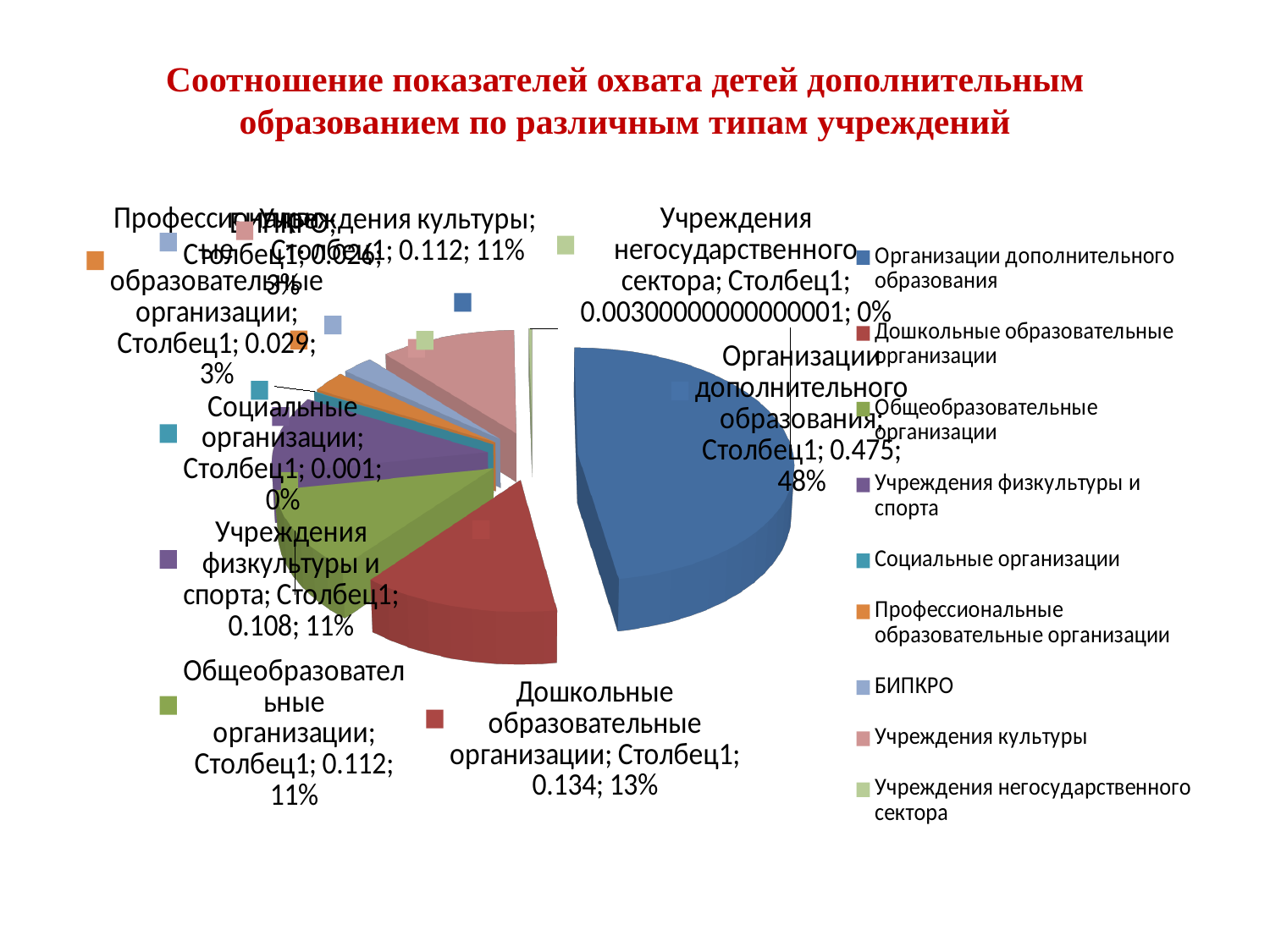
What value is shown for Учреждения физкультуры и спорта? 0.108 What value is shown for Организации дополнительного образования? 0.475 Which category has the largest slice of the pie? Организации дополнительного образования What kind of chart is shown on the slide? pie chart What value is shown for Социальные организации? 0.001 What value is shown for Дошкольные образовательные организации? 0.134 What is the difference between the value for Организации дополнительного образования and the value for Дошкольные образовательные организации? 0.341 What percentage share does the slice for Организации дополнительного образования have? 48% How many categories does the legend of the pie chart list? 9 Which is larger, the value for Дошкольные образовательные организации or the value for Общеобразовательные организации? Дошкольные образовательные организации What percentage share does the slice for Дошкольные образовательные организации have? 13% What percentage share does the slice for Учреждения культуры have? 11%